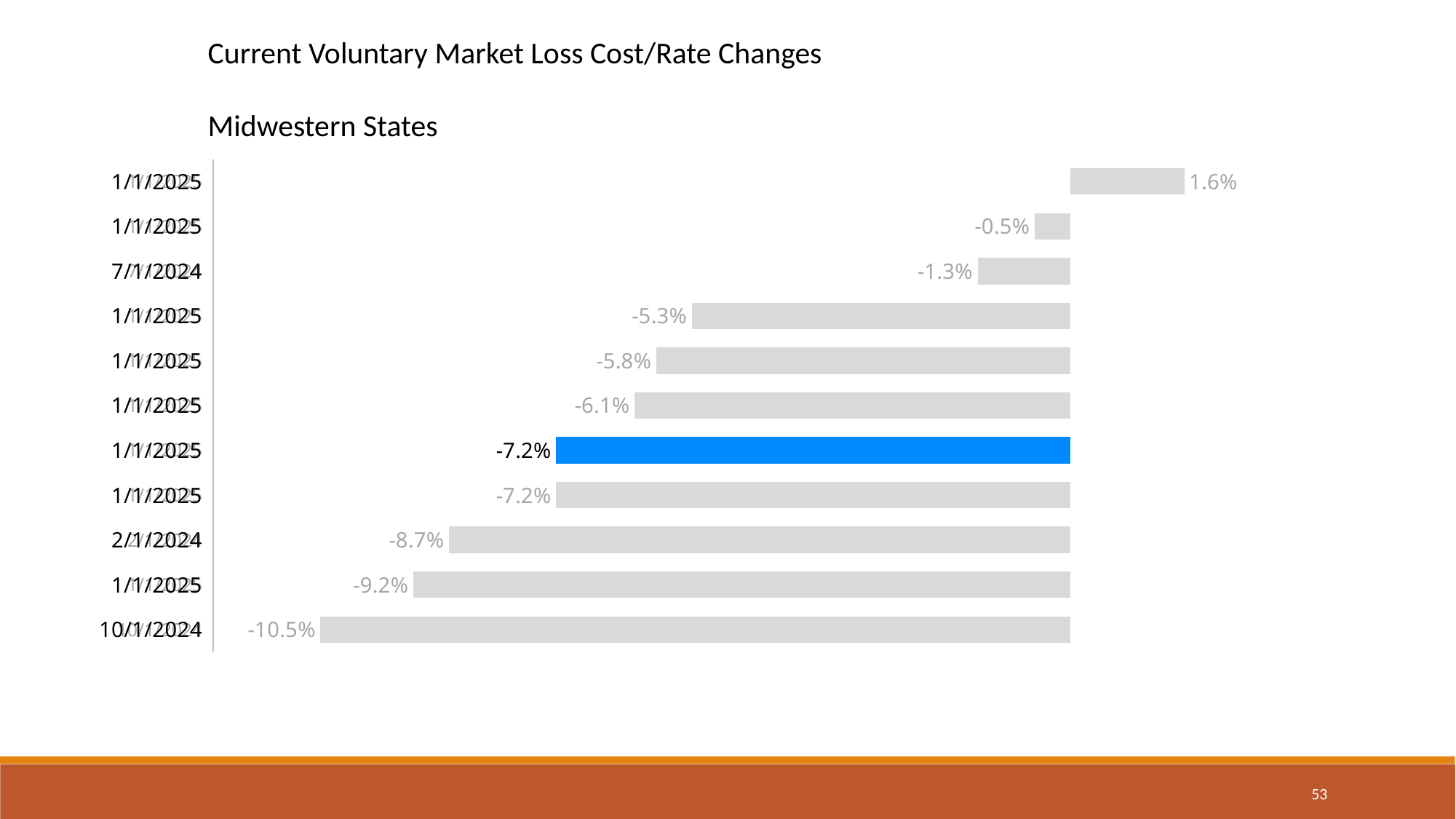
How many bars in the chart have a positive value? 1 What colour is the single highlighted bar in the chart? blue What value is labelled on the bottom bar of the chart? -10.5% How many bars are plotted in the chart? 11 What value is labelled on the topmost bar of the chart? 1.6% What is the highest value shown in the chart? 1.6% How many bars in the chart are labelled -7.2%? 2 What is the lowest value shown in the chart? -10.5% What value is labelled on the blue highlighted bar? -7.2% What kind of chart is shown on the slide? bar chart What is the subtitle shown directly above the chart? Midwestern States What is the difference between the highest value (1.6%) and the lowest value (-10.5%) in the chart? 12.1 percentage points